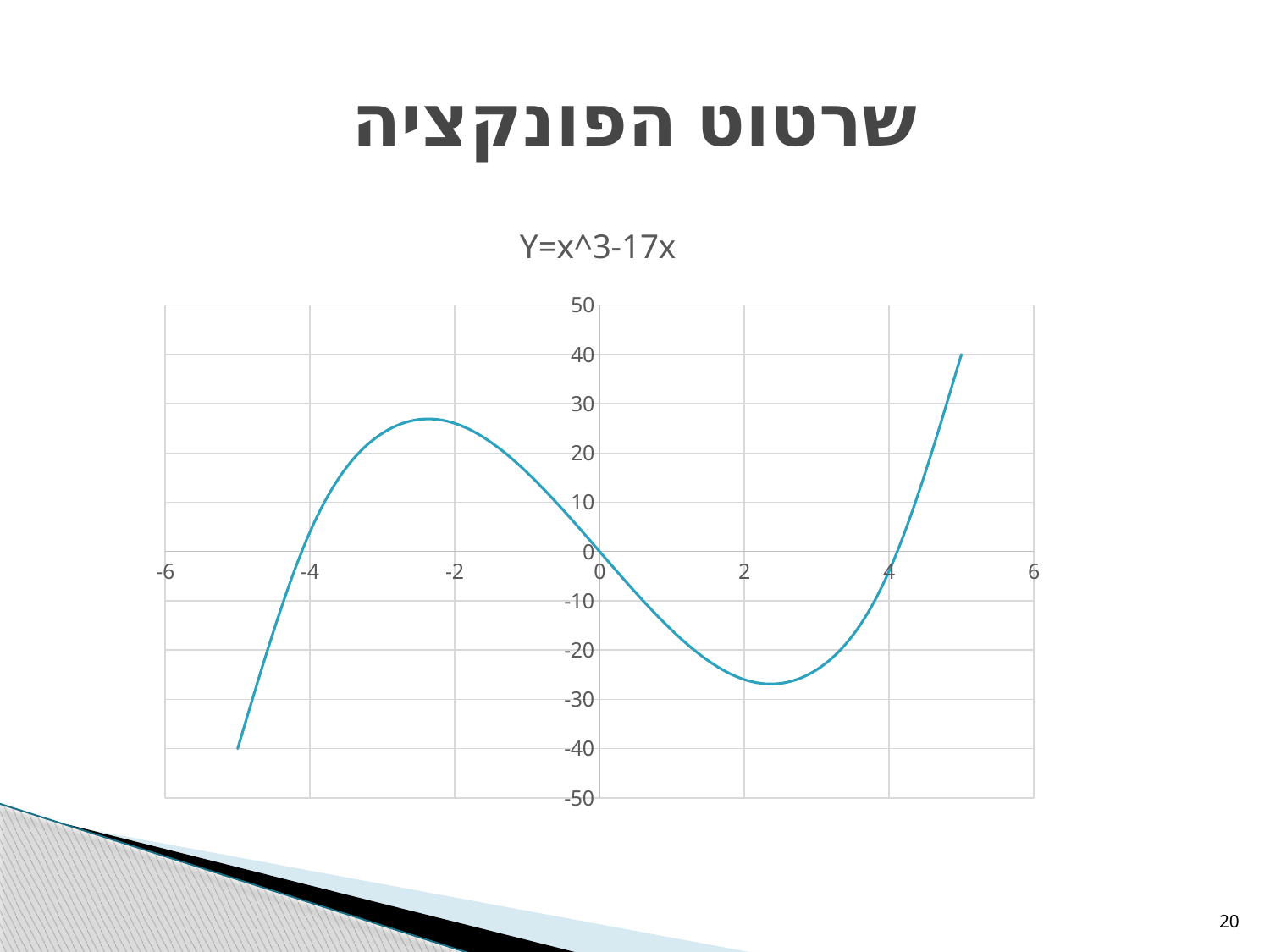
Is the local maximum of the curve (between x = -4 and x = 0) greater or less than 30? less Does the curve rise or fall as x goes from 0 to 2? fall What is the lowest y value reached by the curve on the chart? -40 Which is larger: the value of the curve at x = -2 or at x = 2? x = -2 What is the value of the curve at x = 0? 0 What kind of chart is shown on the slide? line chart What is the highest y value reached by the curve on the chart? 40 Is the value of the curve at x = 2 greater or less than -20? less Is the local minimum of the curve (between x = 0 and x = 4) greater or less than -30? greater Does the curve rise or fall as x goes from -4 to -2? rise What is the title of the chart? Y=x^3-17x